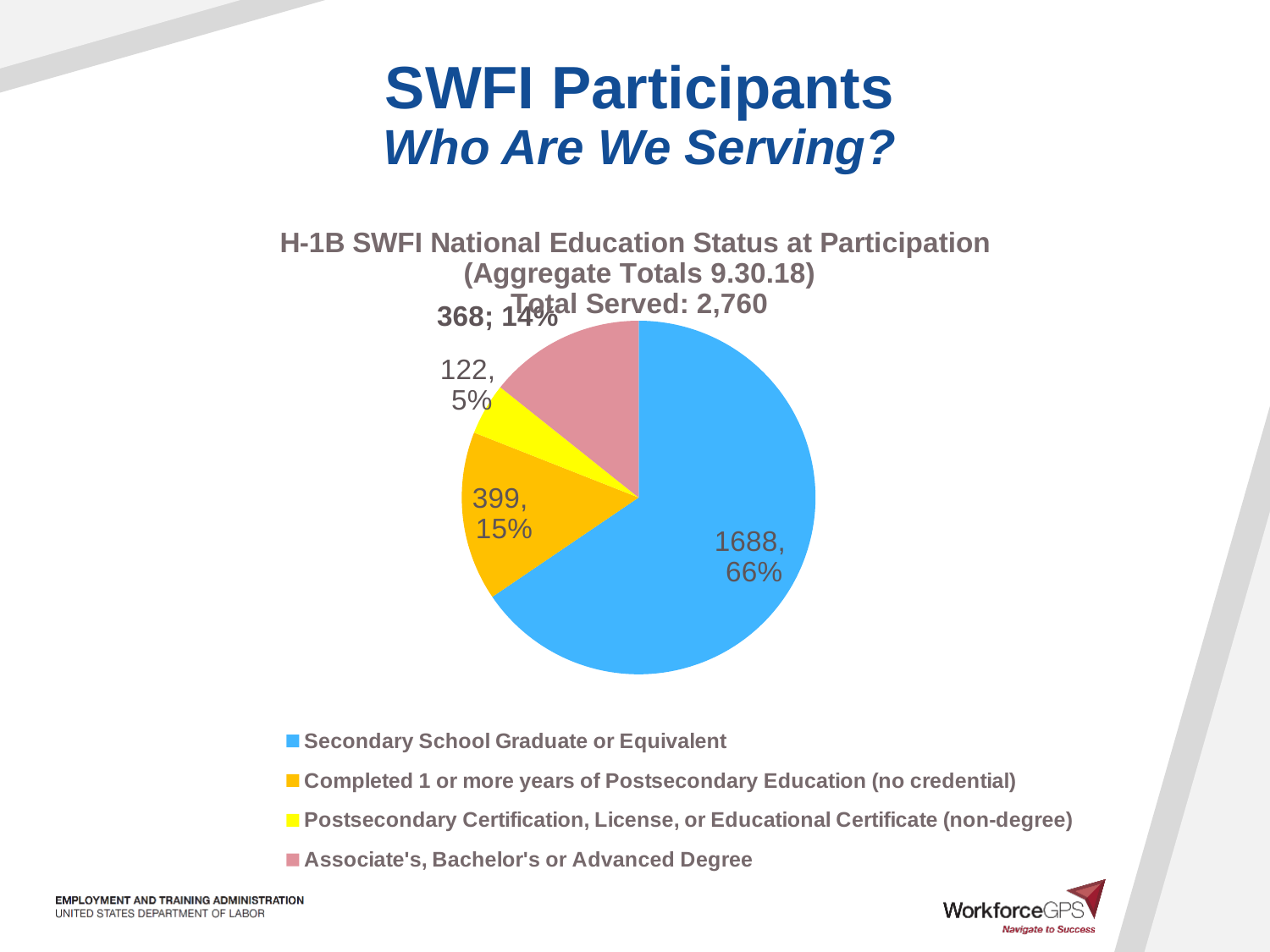
How many slices does the pie chart have? 4 What is the difference in participants between Completed 1 or more years of Postsecondary Education (no credential) and Associate's, Bachelor's or Advanced Degree? 31 What share of the pie is Postsecondary Certification, License, or Educational Certificate (non-degree)? 5% How many participants had an Associate's, Bachelor's or Advanced Degree? 368 Which education category has the largest slice? Secondary School Graduate or Equivalent How many participants were Secondary School Graduate or Equivalent? 1688 What is the total number served according to the chart title? 2,760 Which education category has the smallest slice? Postsecondary Certification, License, or Educational Certificate (non-degree) What kind of chart is shown on the slide? Pie chart What share of the pie is Secondary School Graduate or Equivalent? 66% How many participants had Completed 1 or more years of Postsecondary Education (no credential)? 399 How many entries does the legend list? 4